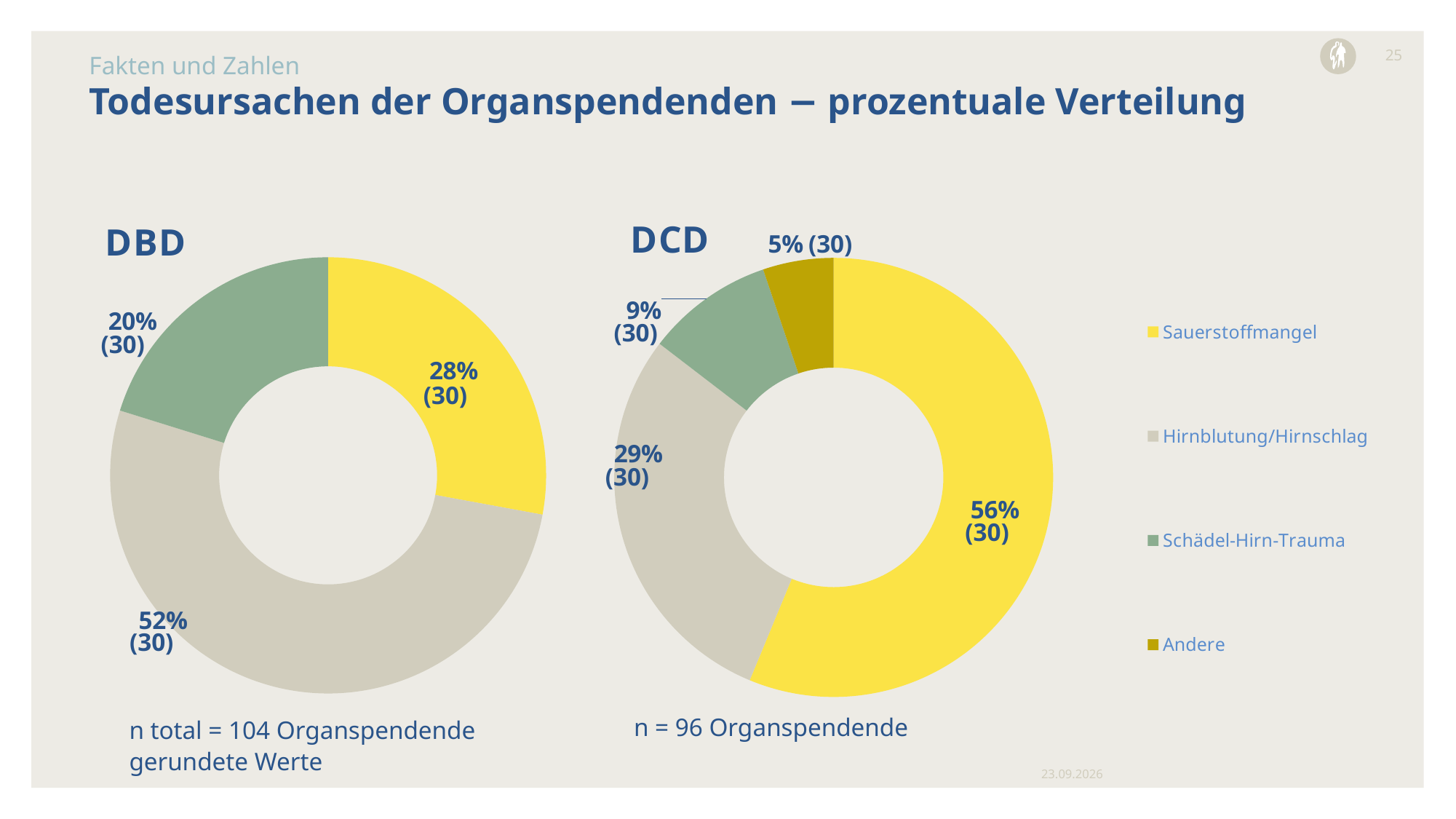
Which colour represents Schädel-Hirn-Trauma in the legend? Green In the DBD chart, which is larger: the share for Sauerstoffmangel or the share for Schädel-Hirn-Trauma? Sauerstoffmangel In the DCD chart, what percentage is shown for Sauerstoffmangel? 56% In the DCD chart, what is the difference in percentage points between Sauerstoffmangel and Hirnblutung/Hirnschlag? 27 How many entries does the legend list? 4 In the DCD chart, which cause of death has the smallest share? Andere How many slices does the DCD chart have? 4 In the DBD chart, what percentage is shown for Hirnblutung/Hirnschlag? 52% In the DBD chart, which cause of death has the largest share? Hirnblutung/Hirnschlag What type of chart is used for DBD and DCD on this slide? Donut (pie) chart In the DBD chart, what percentage is shown for Sauerstoffmangel? 28% In the DCD chart, what percentage is shown for Andere? 5%